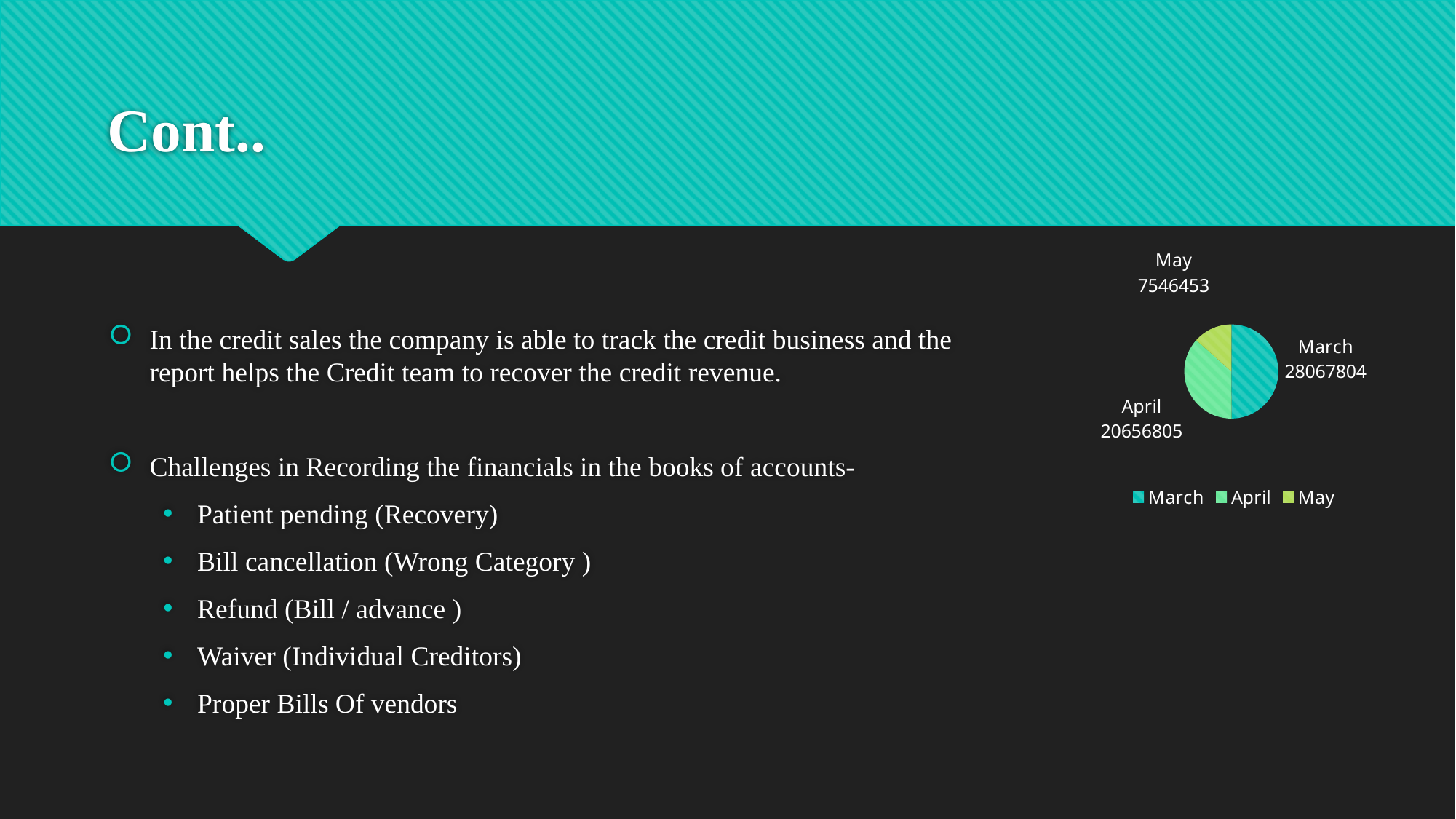
What is the difference between the April and May values in the pie chart? 13110352 What is the value for May in the pie chart? 7546453 Which is larger in the pie chart, the value for April or the value for May? April How many entries does the legend of the pie chart list? 3 What is the difference between the March and April values in the pie chart? 7410999 What is the value for April in the pie chart? 20656805 What is the value for March in the pie chart? 28067804 What type of chart is shown on the slide? Pie chart Which months are listed in the legend of the pie chart? March, April, May Which month has the largest slice in the pie chart? March Which month has the smallest slice in the pie chart? May How many slices does the pie chart have? 3